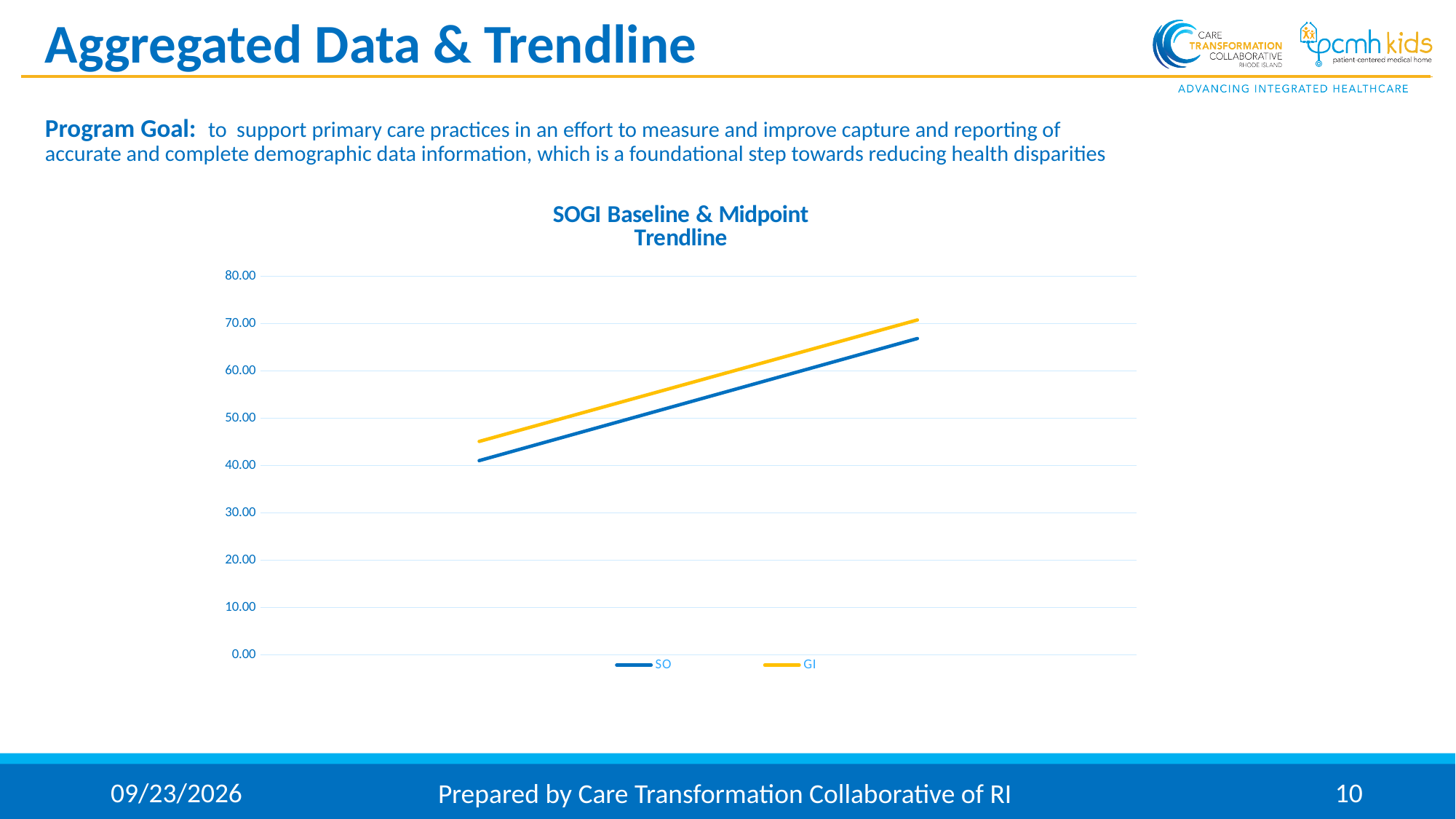
Which series has the higher value at the right-hand end of the lines, SO or GI? GI How many series does the legend list? 2 What are the names of the two series in the legend? SO and GI Do the values for the SO series rise or fall from left to right? rise Is the starting value of the SO line greater or less than 50.00? less Is the ending value of the SO line greater or less than 60.00? greater Is the ending value of the GI line greater or less than 60.00? greater What kind of chart is shown on the slide? line chart What is the title of the chart? SOGI Baseline & Midpoint Trendline Which series has the lower value at the left-hand start of the lines, SO or GI? SO Do the values for the GI series rise or fall from left to right? rise